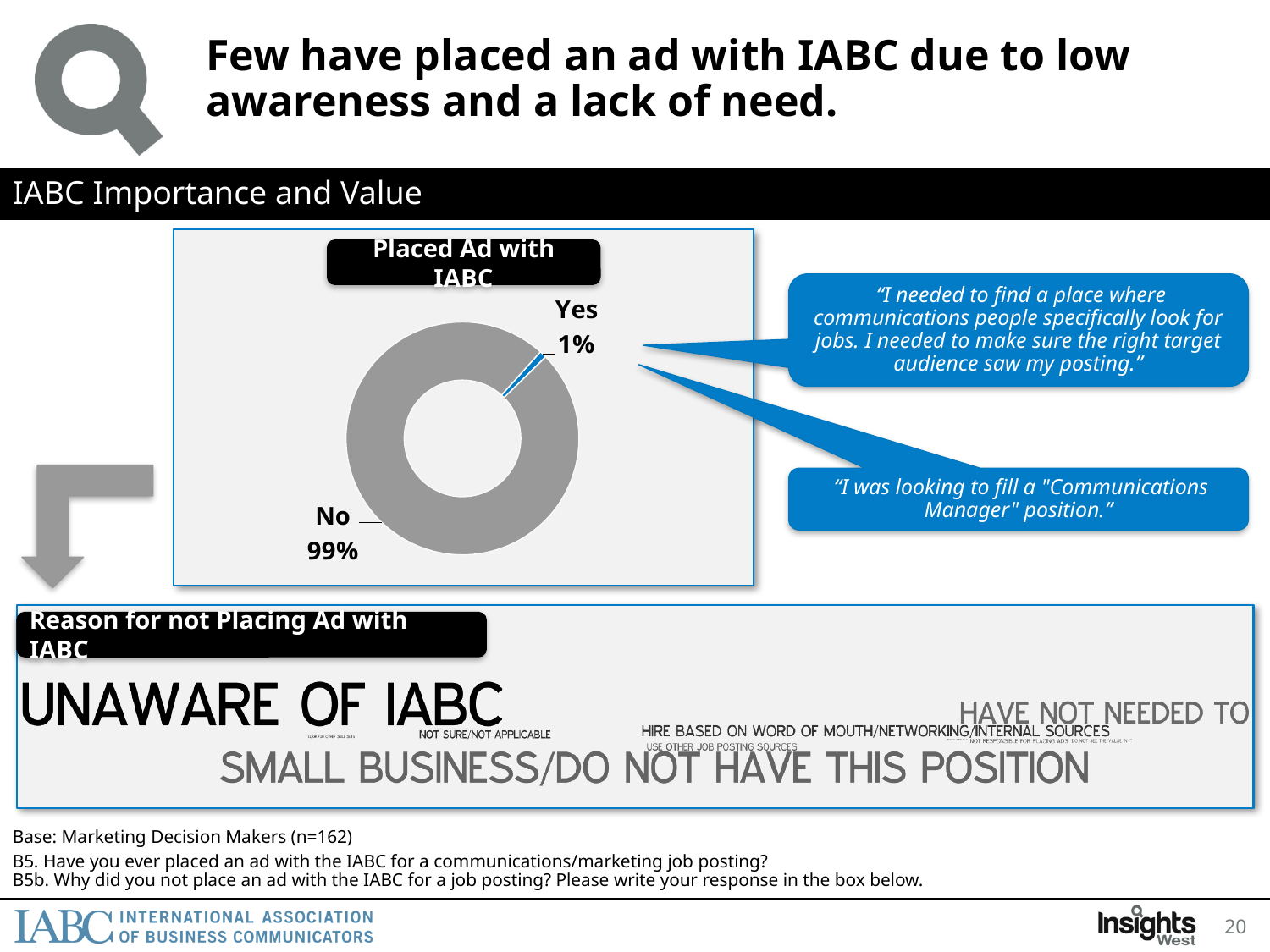
What type of chart is the "Placed Ad with IABC" chart? Donut (pie) chart In the "Placed Ad with IABC" chart, which is larger, the share for Yes or the share for No? No In the "Placed Ad with IABC" chart, what colour is the No segment? Grey In the "Placed Ad with IABC" chart, what percentage of respondents answered Yes? 1% What is the title of the chart in the upper box on the slide? Placed Ad with IABC In the "Placed Ad with IABC" chart, which response has the smallest share? Yes In the "Placed Ad with IABC" chart, what is the difference in percentage points between the No and Yes responses? 98 In the "Placed Ad with IABC" chart, what percentage of respondents answered No? 99% In the "Placed Ad with IABC" chart, which response has the largest share? No In the "Placed Ad with IABC" chart, what share of the total does the Yes segment represent? 1% How many categories are shown in the "Placed Ad with IABC" chart? 2